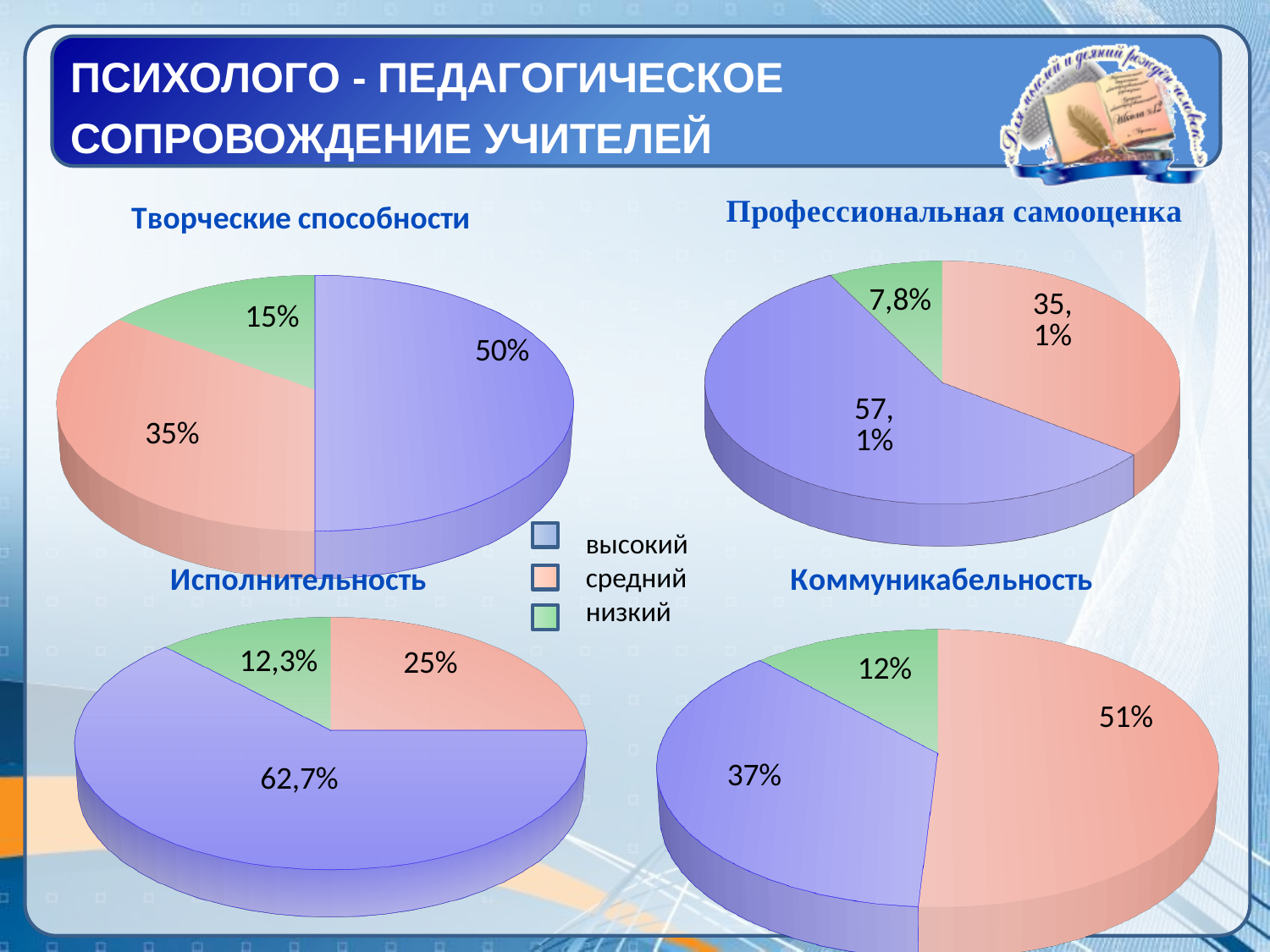
In the "Профессиональная самооценка" chart, what is the difference between the "высокий" and "средний" shares? 22% In the "Коммуникабельность" chart, which category has the largest slice? средний In the "Творческие способности" chart, which category has the smallest slice? низкий In the "Коммуникабельность" chart, what is the value for "высокий"? 37% In the "Исполнительность" chart, what is the share for "средний"? 25% How many entries does the shared legend list? 3 In the "Исполнительность" chart, which is larger, "средний" or "низкий"? средний In the "Творческие способности" chart, what is the share for "высокий"? 50% What kind of chart is used for "Творческие способности"? pie chart In the "Профессиональная самооценка" chart, which category has the largest slice? высокий In the "Профессиональная самооценка" chart, what is the value for "низкий"? 7,8% How many slices does the "Коммуникабельность" pie chart have? 3